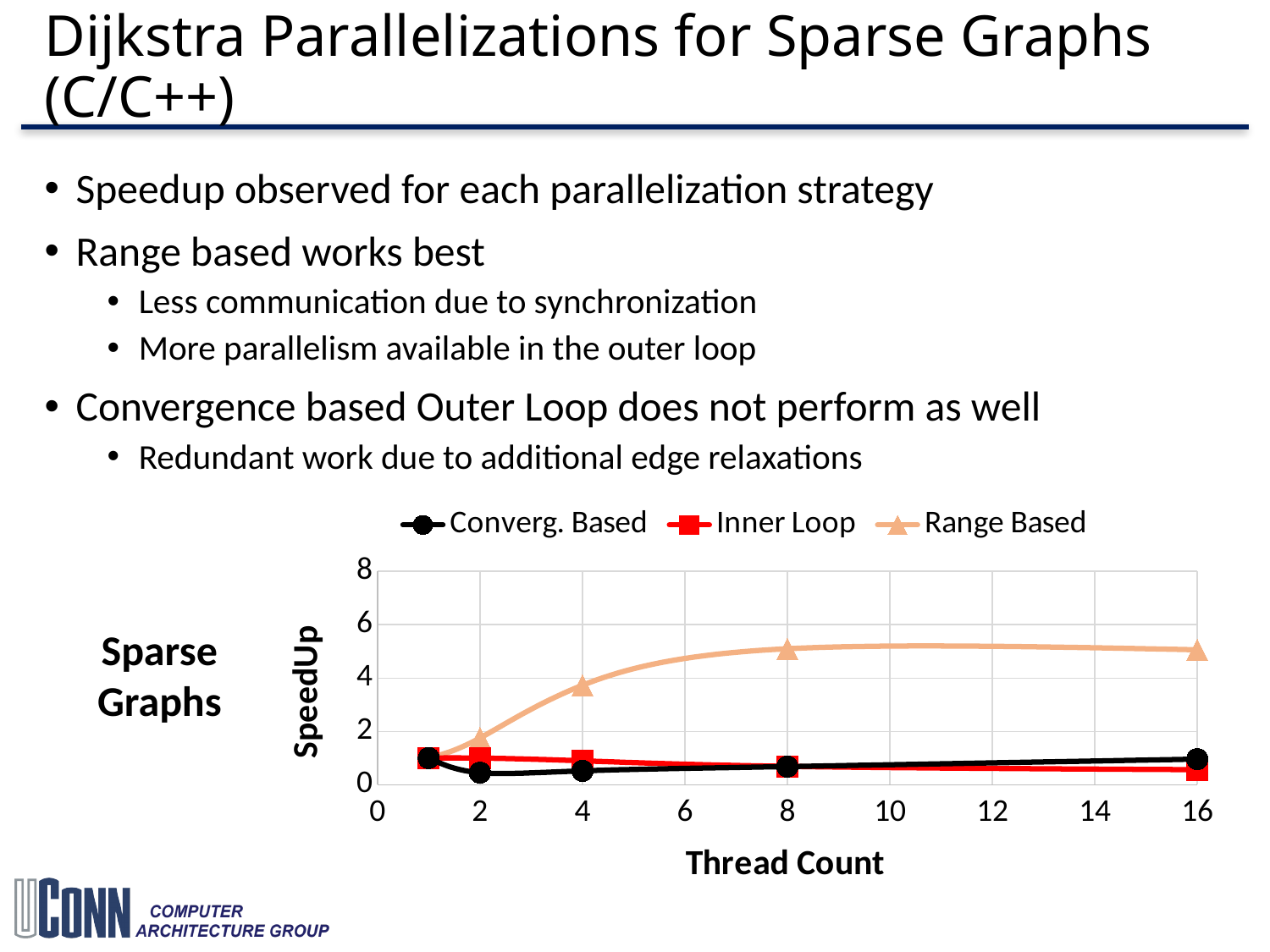
What is the label of the y axis? SpeedUp How many series does the chart legend list? 3 What is the label of the x axis? Thread Count What kind of chart is shown on the slide? line chart Is the speedup for Range Based at 8 threads greater or less than 4? greater At 4 threads, which series has the larger speedup, Range Based or Inner Loop? Range Based Is the speedup for Range Based at 4 threads greater or less than 2? greater How many data points are plotted for the Range Based series? 5 Is the speedup for Inner Loop at 16 threads greater or less than 2? less Which series has the highest speedup at a thread count of 16? Range Based Does the Range Based speedup rise or fall as the thread count increases from 1 to 8? rise Which series has the lowest speedup at a thread count of 2? Converg. Based